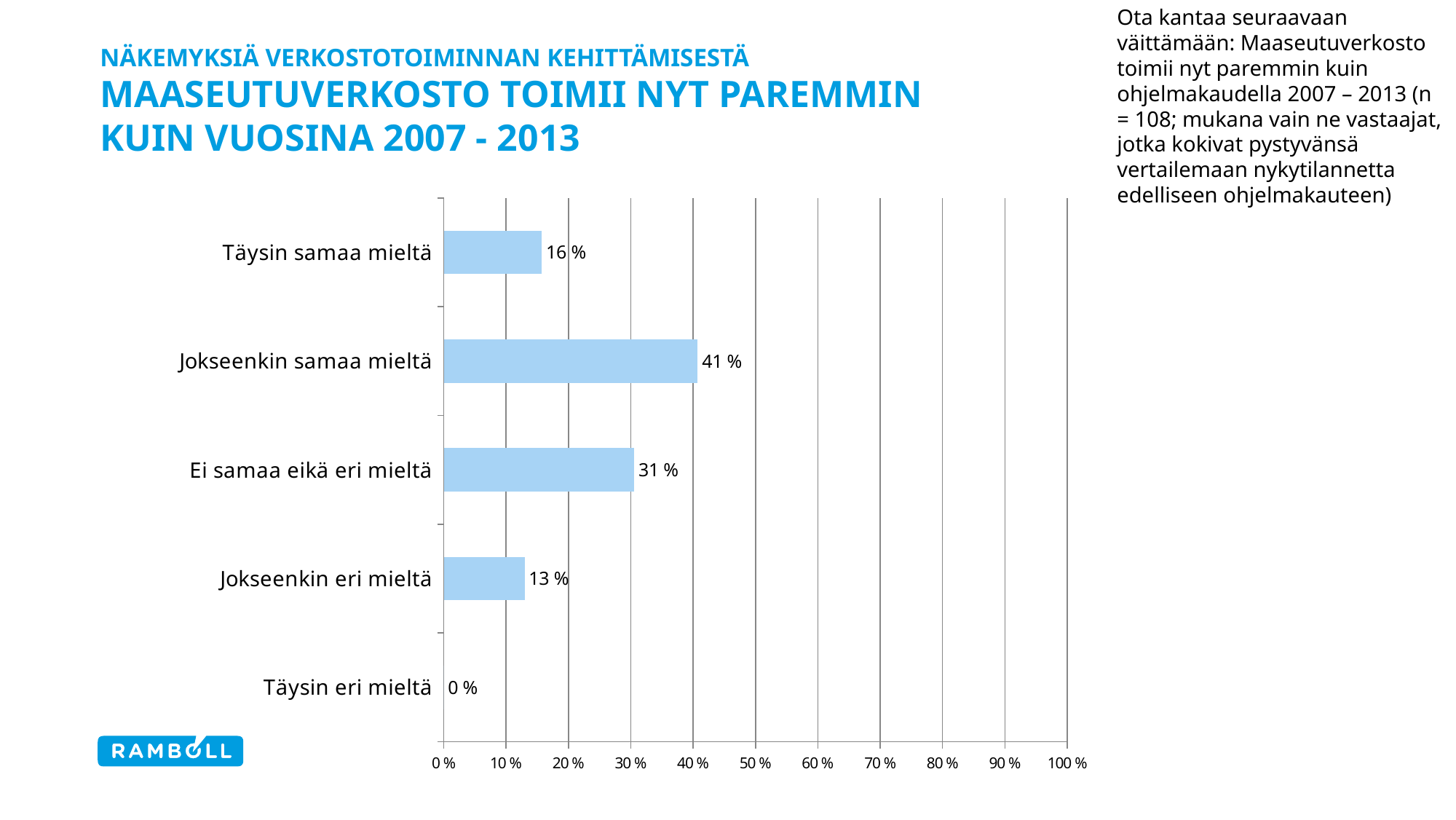
What is the value for "Täysin eri mieltä"? 0 % What is the value for "Ei samaa eikä eri mieltä"? 31 % What is the value for "Täysin samaa mieltä"? 16 % What is the difference between the values for "Jokseenkin samaa mieltä" and "Ei samaa eikä eri mieltä"? 10 % Which category has the lowest value? Täysin eri mieltä What kind of chart is shown on the slide? bar chart Which category has the highest value? Jokseenkin samaa mieltä Which is larger, the value for "Täysin samaa mieltä" or the value for "Jokseenkin eri mieltä"? Täysin samaa mieltä What is the highest value shown on the x axis? 100 % How many categories are shown in the chart? 5 Is the value for "Ei samaa eikä eri mieltä" greater or less than 40 %? less What is the value for "Jokseenkin samaa mieltä"? 41 %